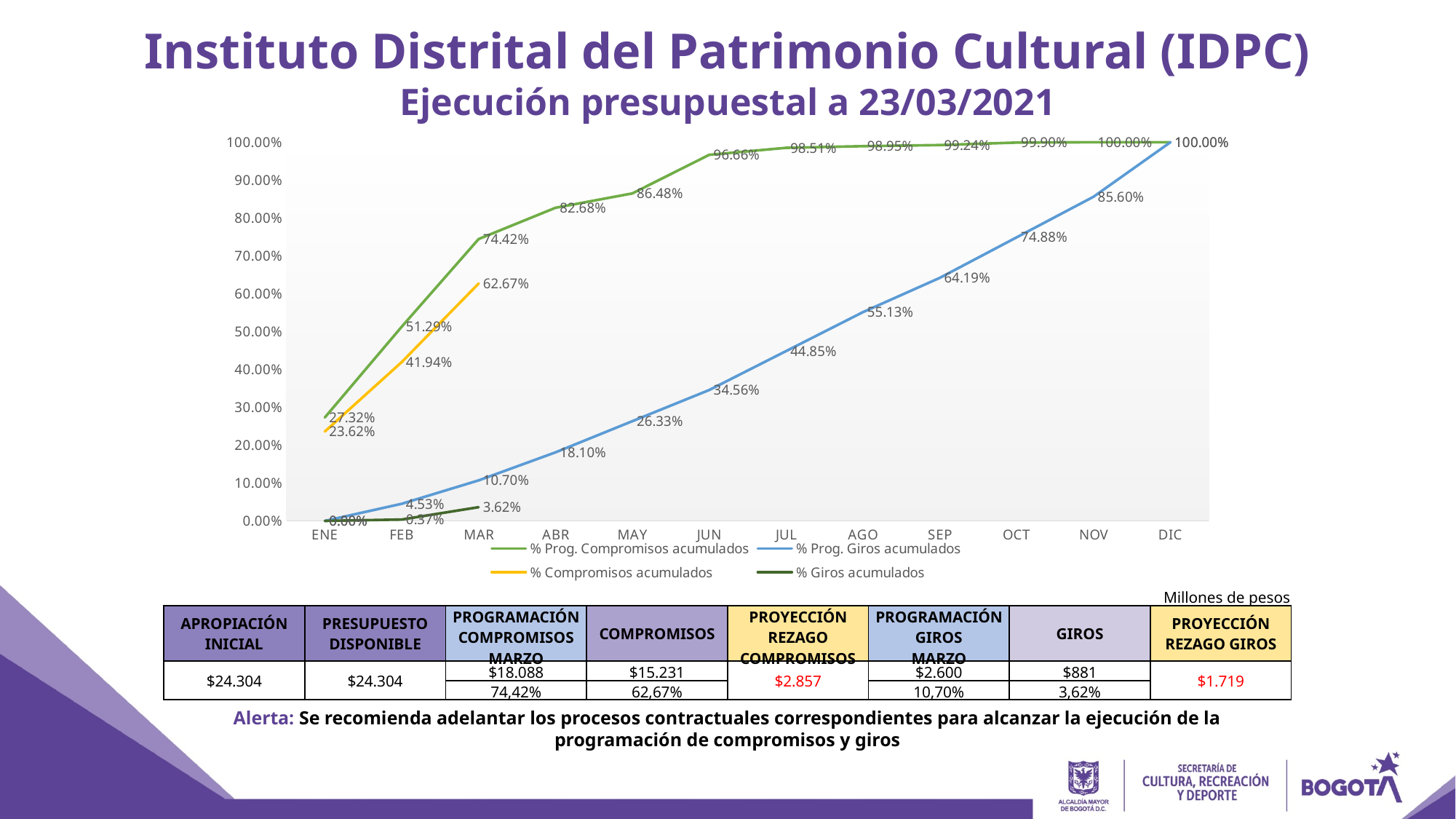
Which is larger in FEB: % Prog. Compromisos acumulados or % Compromisos acumulados? % Prog. Compromisos acumulados Does % Prog. Giros acumulados rise or fall from ENE to DIC? Rise In which month does % Prog. Giros acumulados reach its highest value? DIC How many months are shown on the x axis of the chart? 12 What is the value of % Prog. Compromisos acumulados in JUN? 96.66% What is the value of % Giros acumulados in FEB? 0.37% What is the value of % Prog. Giros acumulados in JUL? 44.85% How many series does the chart legend list? 4 What is the value of % Compromisos acumulados in MAR? 62.67% What is the difference between % Prog. Compromisos acumulados and % Compromisos acumulados in MAR? 11.75% What kind of chart is shown on the slide? Line chart What is the value of % Prog. Compromisos acumulados in MAR? 74.42%